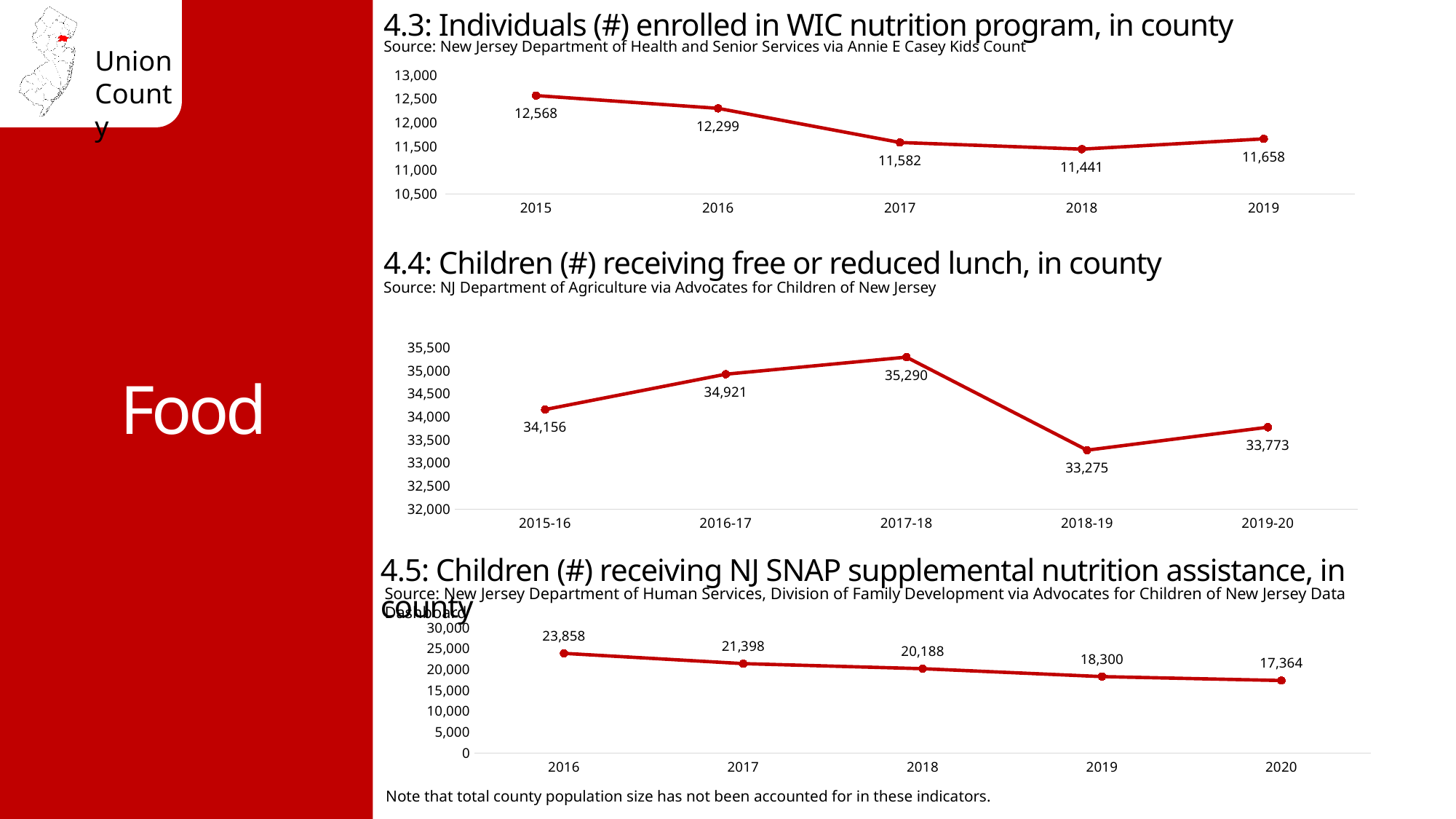
In the chart '4.4: Children (#) receiving free or reduced lunch, in county', which school year has the highest value? 2017-18 In the chart '4.3: Individuals (#) enrolled in WIC nutrition program, in county', which year has the lowest value? 2018 In the chart '4.3: Individuals (#) enrolled in WIC nutrition program, in county', how many data points are plotted? 5 In the chart '4.4: Children (#) receiving free or reduced lunch, in county', what is the value for 2016-17? 34,921 In the chart '4.5: Children (#) receiving NJ SNAP supplemental nutrition assistance, in county', what is the difference between the 2016 and 2020 values? 6,494 In the chart '4.3: Individuals (#) enrolled in WIC nutrition program, in county', what is the value for 2017? 11,582 In the chart '4.3: Individuals (#) enrolled in WIC nutrition program, in county', what is the difference between the 2015 and 2019 values? 910 In the chart '4.4: Children (#) receiving free or reduced lunch, in county', what is the difference between the 2017-18 and 2018-19 values? 2,015 What type of chart is used for '4.5: Children (#) receiving NJ SNAP supplemental nutrition assistance, in county'? line chart In the chart '4.4: Children (#) receiving free or reduced lunch, in county', which is larger, the value for 2015-16 or the value for 2019-20? 2015-16 In the chart '4.5: Children (#) receiving NJ SNAP supplemental nutrition assistance, in county', what is the value for 2018? 20,188 In the chart '4.5: Children (#) receiving NJ SNAP supplemental nutrition assistance, in county', do the values rise or fall from 2016 to 2020? fall